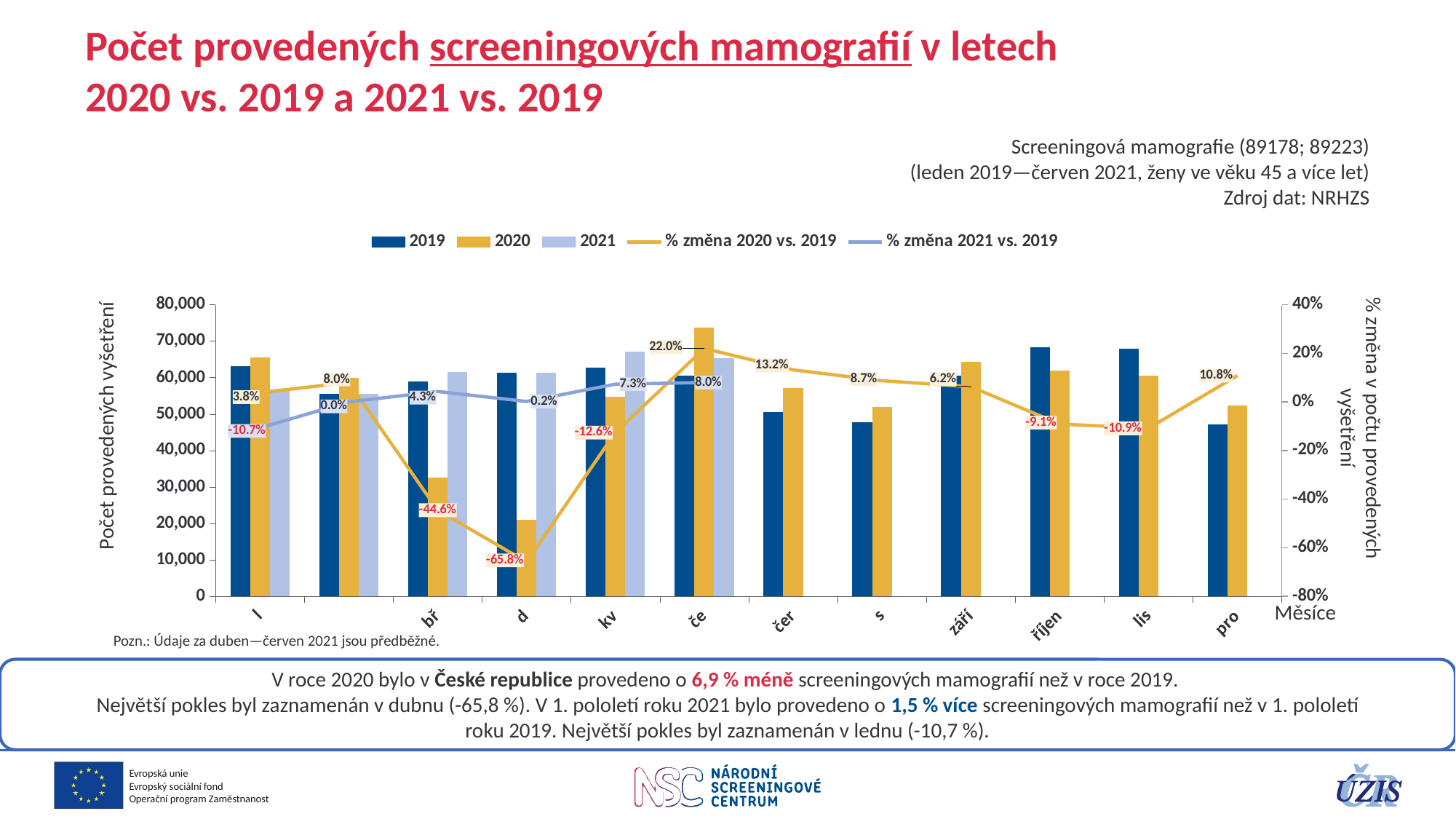
What is the value of '% změna 2020 vs. 2019' for the month 'pro'? 10.8% What is the value of '% změna 2021 vs. 2019' for the month 'če'? 8.0% Which is larger, '% změna 2020 vs. 2019' in 'říjen' or in 'lis'? říjen What is the difference between '% změna 2021 vs. 2019' in 'kv' and in 'l'? 18.0 percentage points Is the 2020 bar for the month 'd' greater or less than 30,000? less Is the 2020 bar for the month 'če' greater or less than 70,000? greater In which month is '% změna 2020 vs. 2019' highest? če In which month is '% změna 2020 vs. 2019' lowest? d How many series does the legend list? 5 How many months are shown on the x axis? 12 What kind of chart is shown on the slide? A combined bar and line chart What is the value of '% změna 2020 vs. 2019' for the month 'd'? -65.8%